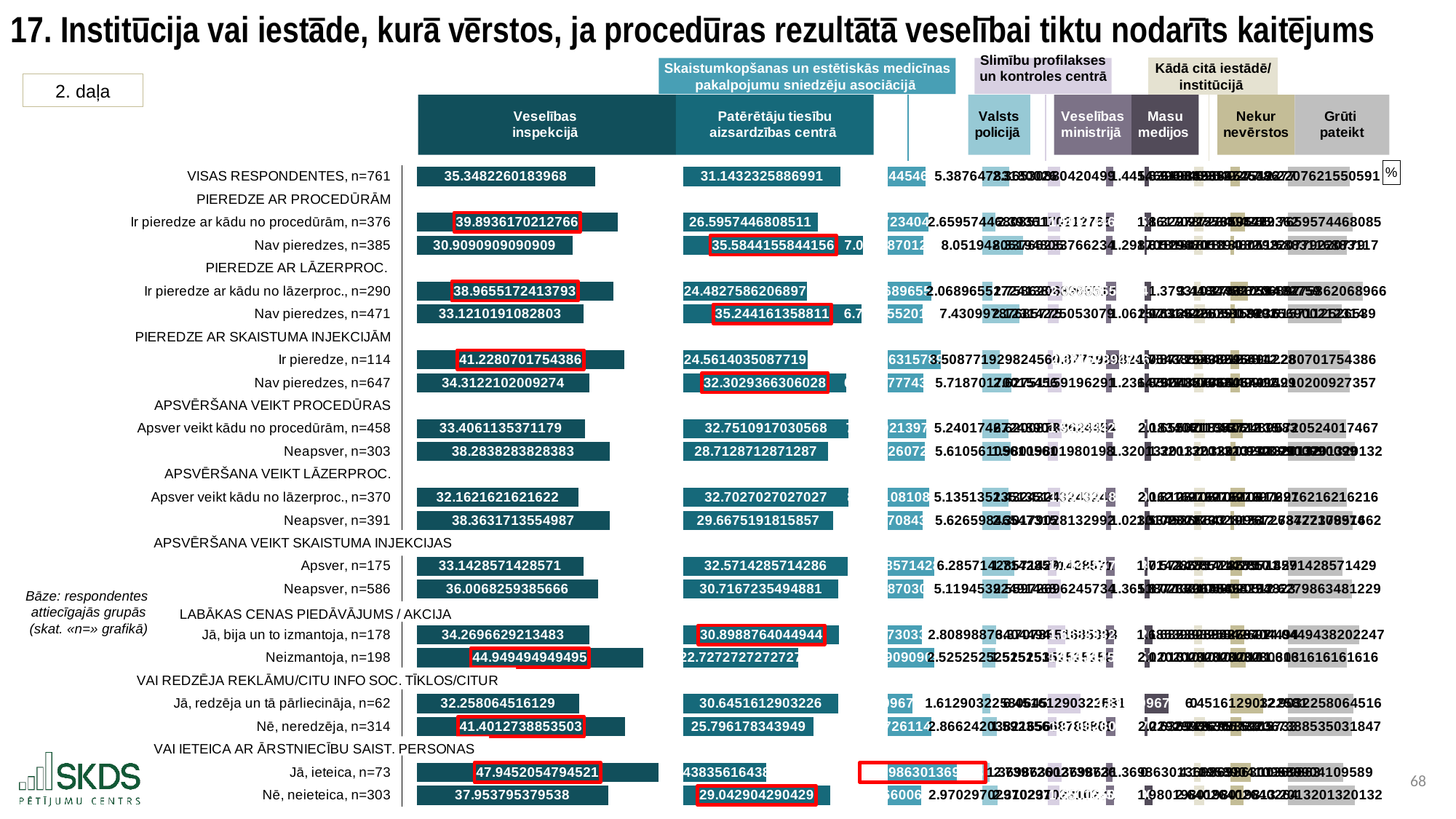
What is the value for 'Patērētāju tiesību aizsardzības centrā' for Neizmantoja, n=198? 22.7272727272727 For Nē, neredzēja, n=314, which is larger: 'Veselības inspekcijā' or 'Patērētāju tiesību aizsardzības centrā'? Veselības inspekcijā What is the value for 'Patērētāju tiesību aizsardzības centrā' for Nav pieredzes, n=385? 35.5844155844156 What is the value for 'Veselības inspekcijā' for Ir pieredze, n=114? 41.2280701754386 Which category has the highest value for 'Veselības inspekcijā'? Jā, ieteica, n=73 What is the value for 'Veselības inspekcijā' for Jā, ieteica, n=73? 47.9452054794521 What is the value for 'Veselības inspekcijā' for VISAS RESPONDENTES, n=761? 35.3482260183968 Which category has the lowest value for 'Veselības inspekcijā'? Nav pieredzes, n=385 What kind of chart is shown on the slide? bar chart For Neizmantoja, n=198, what is the difference between the 'Veselības inspekcijā' value and the 'Patērētāju tiesību aizsardzības centrā' value? 22.2222222222223 For Nav pieredzes, n=471, which is larger: 'Veselības inspekcijā' or 'Patērētāju tiesību aizsardzības centrā'? Patērētāju tiesību aizsardzības centrā